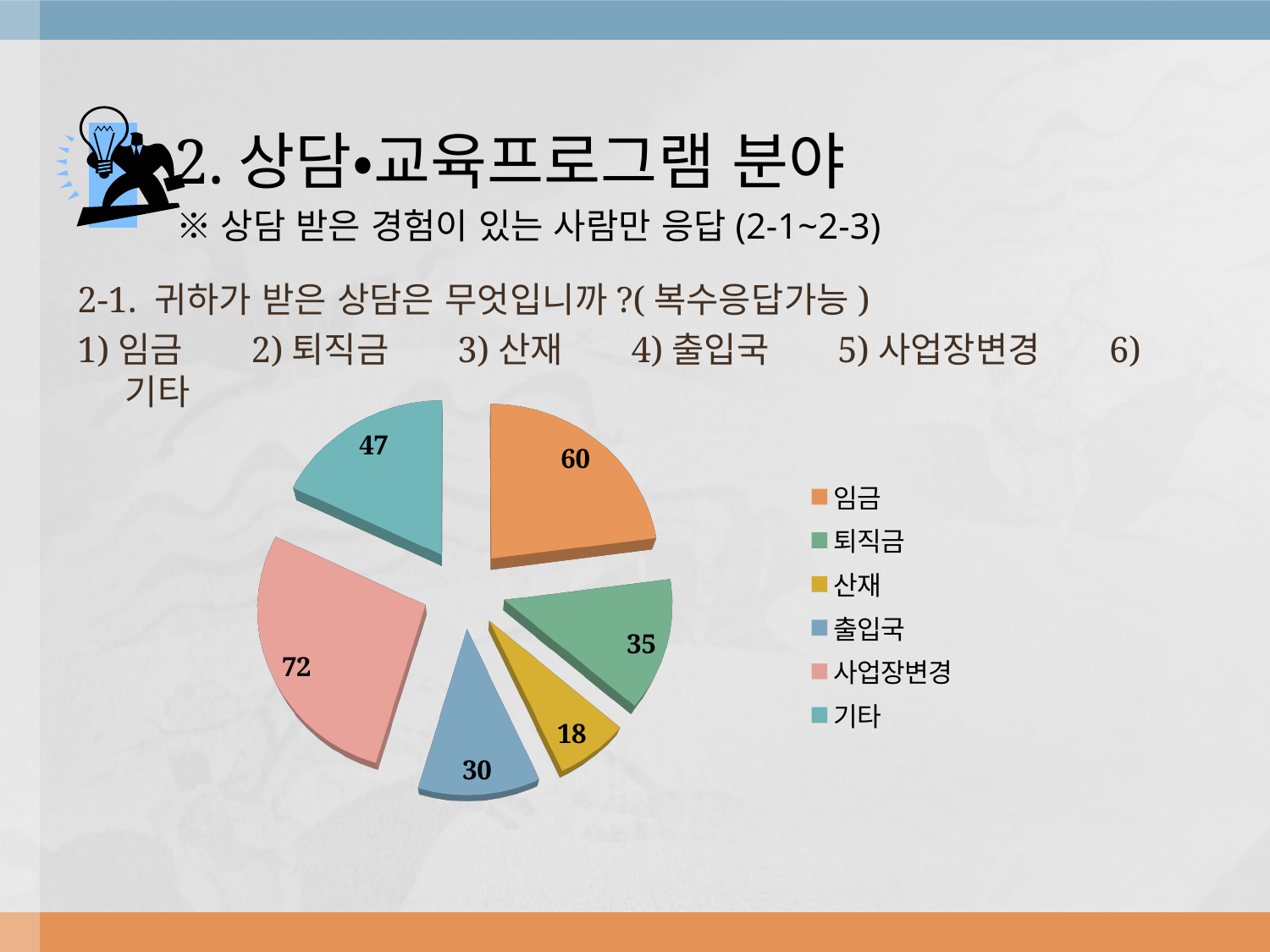
Which is larger, the value for 기타 or the value for 퇴직금? 기타 What is the value for 임금 in the pie chart? 60 What is the total of all the values shown in the pie chart? 262 What is the value for 사업장변경 in the pie chart? 72 What is the difference between the values for 퇴직금 and 출입국? 5 What is the value for 산재 in the pie chart? 18 What kind of chart is shown on the slide? pie chart Which category has the largest slice in the pie chart? 사업장변경 Which category has the smallest slice in the pie chart? 산재 What is the value for 기타 in the pie chart? 47 What is the difference between the values for 사업장변경 and 임금? 12 How many categories are shown in the pie chart? 6